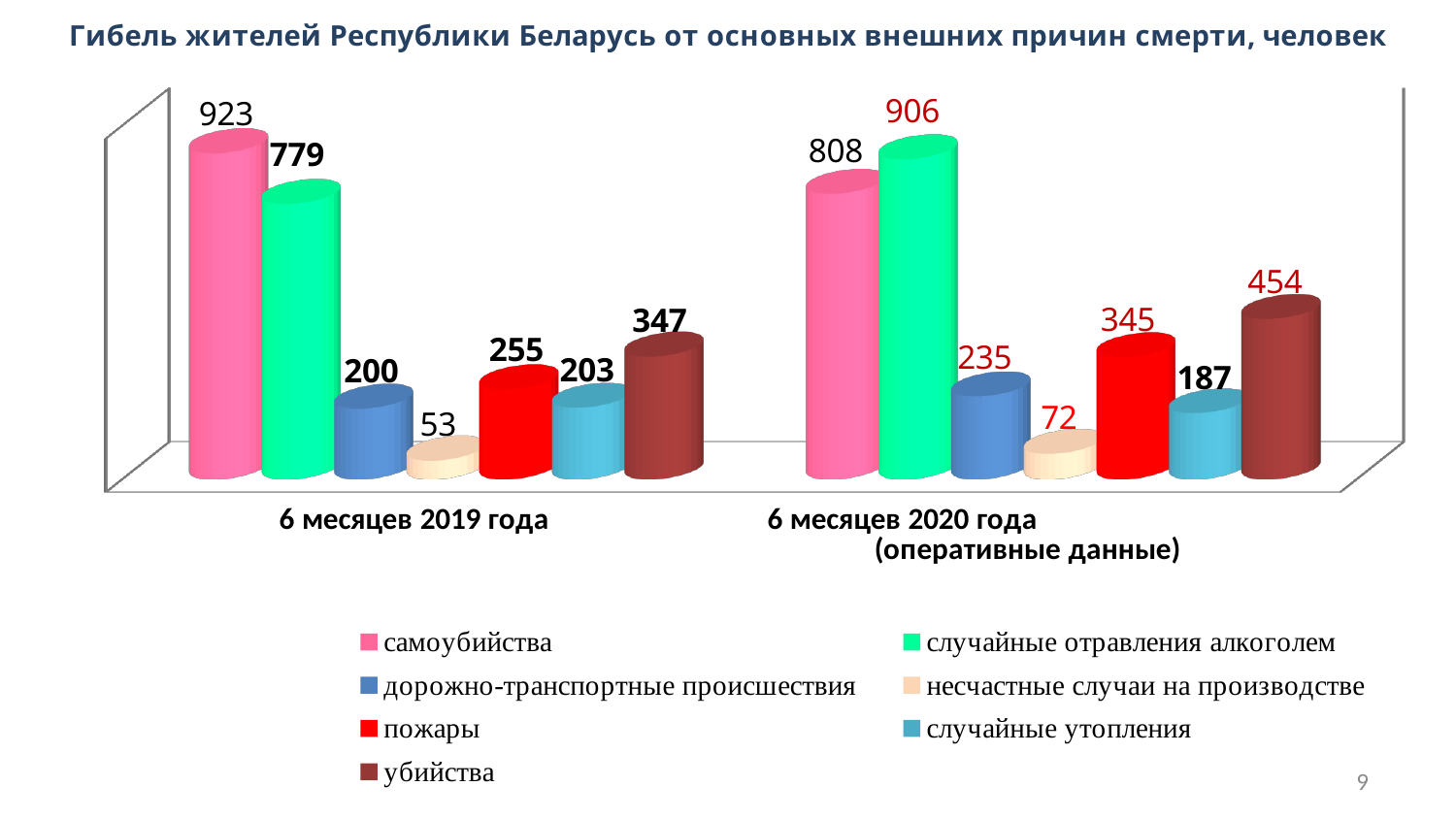
Какая причина смерти имеет наименьшее значение за 6 месяцев 2019 года? несчастные случаи на производстве Сколько человек погибло от случайных отравлений алкоголем за 6 месяцев 2020 года? 906 Какого типа эта диаграмма? столбчатая (bar chart) Сколько человек погибло от убийств за 6 месяцев 2020 года? 454 Сколько человек погибло от несчастных случаев на производстве за 6 месяцев 2019 года? 53 Сколько категорий (периодов) показано на оси x диаграммы? 2 Какая причина смерти имеет наибольшее значение за 6 месяцев 2020 года? случайные отравления алкоголем Сколько человек погибло от самоубийств за 6 месяцев 2019 года? 923 Сколько серий (причин смерти) перечислено в легенде диаграммы? 7 На сколько число погибших от убийств за 6 месяцев 2020 года больше, чем за 6 месяцев 2019 года? 107 Что больше: число погибших от пожаров за 6 месяцев 2019 года или за 6 месяцев 2020 года? 6 месяцев 2020 года Каким цветом на диаграмме обозначены пожары? красным